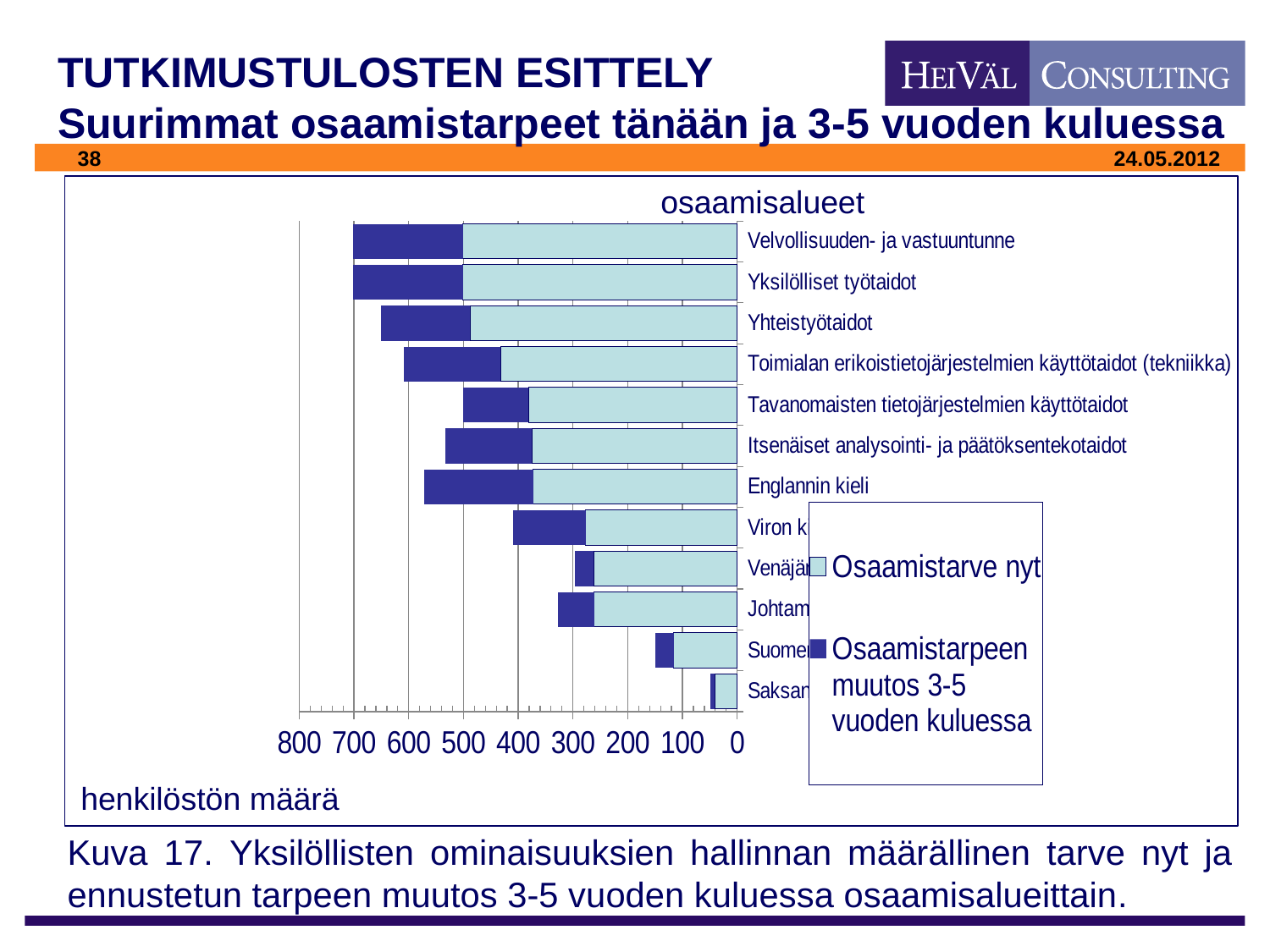
Which has the longer total bar: 'Yhteistyötaidot' or 'Tavanomaisten tietojärjestelmien käyttötaidot'? Yhteistyötaidot Is the 'Osaamistarve nyt' value for 'Velvollisuuden- ja vastuuntunne' greater or less than 400? greater How many categories (bars) are plotted in the chart? 12 What kind of chart is shown on the slide? Stacked horizontal bar chart Which legend entry is shown with the dark blue colour? Osaamistarpeen muutos 3-5 vuoden kuluessa Which has the larger 'Osaamistarve nyt' value: 'Velvollisuuden- ja vastuuntunne' or 'Englannin kieli'? Velvollisuuden- ja vastuuntunne Is the 'Osaamistarve nyt' value for 'Englannin kieli' greater or less than 300? greater Is the total bar length for 'Yhteistyötaidot' greater or less than 600? greater How many series does the chart legend list? 2 What is the title shown above the chart? osaamisalueet